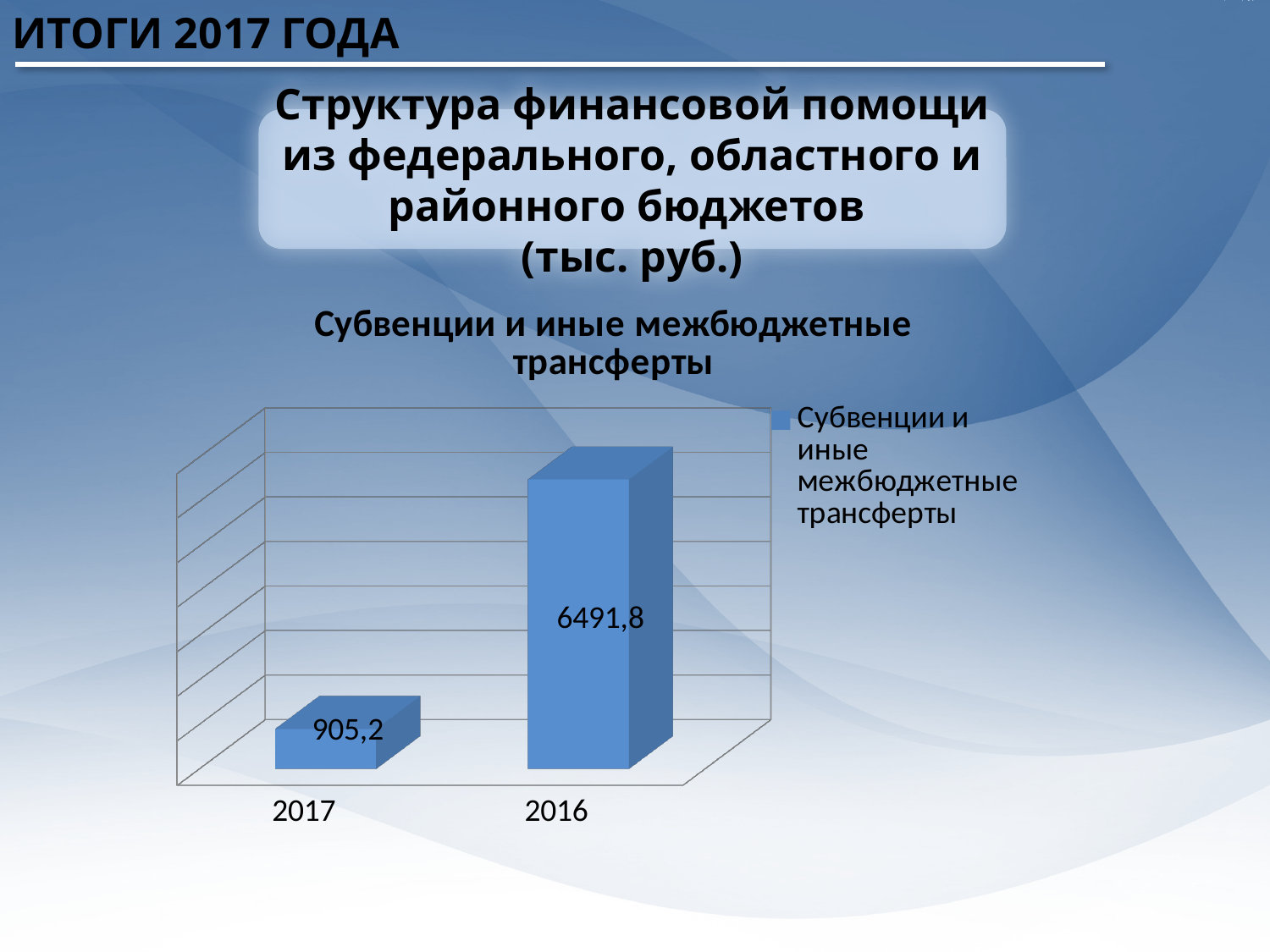
What is the value for 2017 in the chart? 905,2 Is the value for 2017 larger or smaller than the value for 2016? smaller How many series does the legend list? 1 What is the difference between the 2016 value and the 2017 value? 5586,6 What is the value for 2016 in the chart? 6491,8 Which year has the lower value in the chart? 2017 Reading the bars from left to right (2017 then 2016), do the values rise or fall? rise How many categories are shown on the x axis of the chart? 2 Which year has the higher value in the chart? 2016 What kind of chart is shown on the slide? bar chart What is the title of the chart? Субвенции и иные межбюджетные трансферты What is the name of the series listed in the legend? Субвенции и иные межбюджетные трансферты